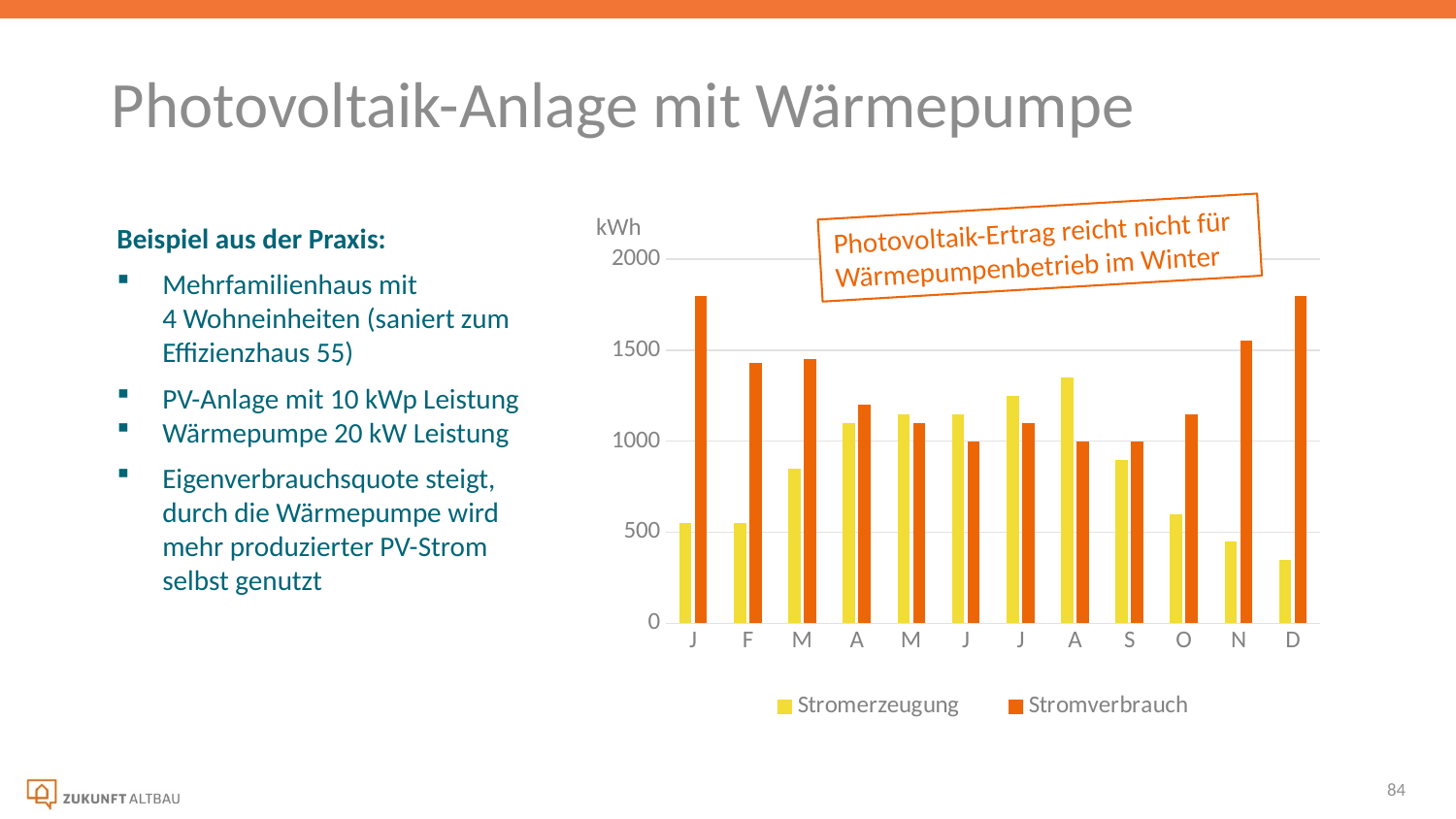
Is the Stromverbrauch value for the first month (J, January) greater or less than 1500? greater What are the two series named in the chart legend? Stromerzeugung and Stromverbrauch How many months (categories) are shown on the x axis of the chart? 12 Which month has the lowest Stromerzeugung value? D (December) Which month has the highest Stromerzeugung value? A (August, the eighth month) Is the Stromerzeugung value for D (December) greater or less than 500? less In the eighth month (A, August), which is larger: Stromerzeugung or Stromverbrauch? Stromerzeugung In D (December), which is larger: Stromerzeugung or Stromverbrauch? Stromverbrauch What kind of chart is shown on the slide? bar chart How many series does the chart legend list? 2 Is the Stromverbrauch value for N (November) greater or less than 1000? greater What unit is shown on the y axis of the chart? kWh